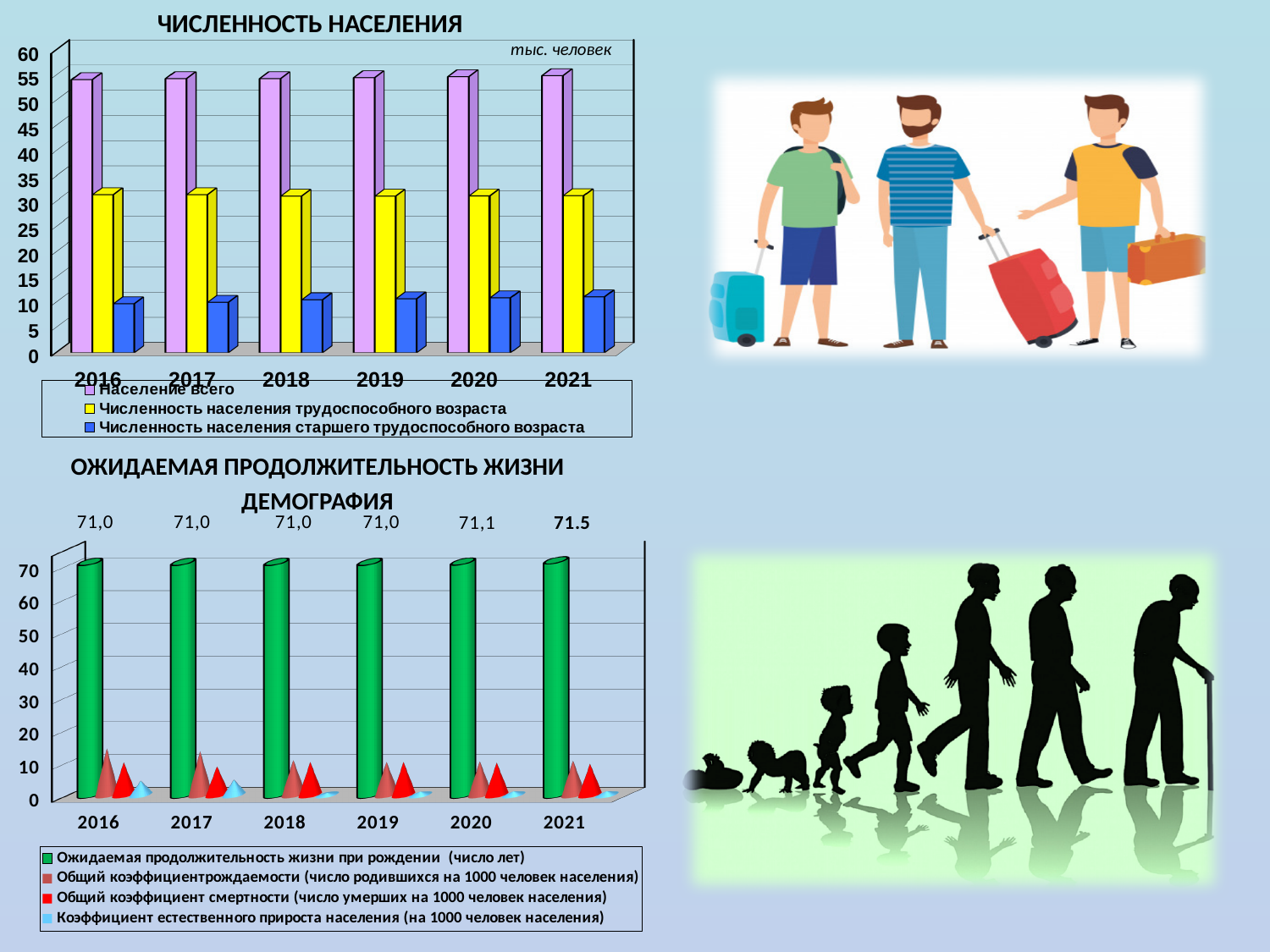
How many series does the legend of the top chart (ЧИСЛЕННОСТЬ НАСЕЛЕНИЯ) list? 3 What unit is indicated in the top-right corner of the top chart (ЧИСЛЕННОСТЬ НАСЕЛЕНИЯ)? тыс. человек In the bottom chart (ОЖИДАЕМАЯ ПРОДОЛЖИТЕЛЬНОСТЬ ЖИЗНИ), what is the life expectancy at birth for 2021? 71.5 In the top chart (ЧИСЛЕННОСТЬ НАСЕЛЕНИЯ), is the value for Население всего in 2016 greater or less than 50? greater In the bottom chart (ОЖИДАЕМАЯ ПРОДОЛЖИТЕЛЬНОСТЬ ЖИЗНИ), what is the life expectancy at birth for 2020? 71,1 In the top chart (ЧИСЛЕННОСТЬ НАСЕЛЕНИЯ), is the value for Численность населения старшего трудоспособного возраста in 2021 greater or less than 15? less In the top chart (ЧИСЛЕННОСТЬ НАСЕЛЕНИЯ), which series has the highest values in every year? Население всего How many years are shown on the x axis of the top chart (ЧИСЛЕННОСТЬ НАСЕЛЕНИЯ)? 6 In the bottom chart (ОЖИДАЕМАЯ ПРОДОЛЖИТЕЛЬНОСТЬ ЖИЗНИ), which year has the highest life expectancy at birth? 2021 In the bottom chart (ОЖИДАЕМАЯ ПРОДОЛЖИТЕЛЬНОСТЬ ЖИЗНИ), which is larger: the life expectancy in 2019 or in 2020? 2020 How many series does the legend of the bottom chart (ОЖИДАЕМАЯ ПРОДОЛЖИТЕЛЬНОСТЬ ЖИЗНИ) list? 4 What kind of chart is the top chart titled ЧИСЛЕННОСТЬ НАСЕЛЕНИЯ? bar chart